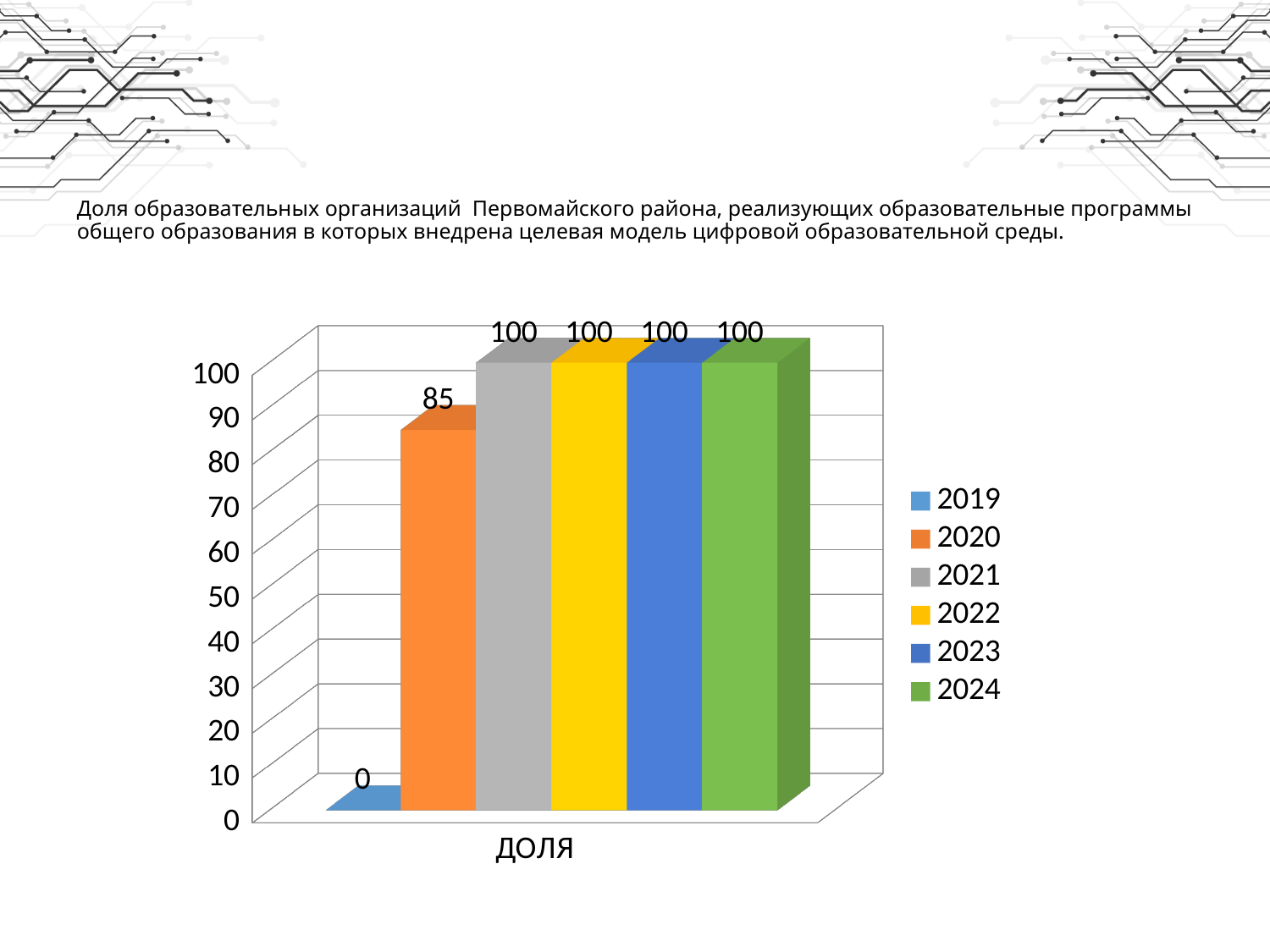
What colour is the bar for 2024? green What is the category label on the x axis? ДОЛЯ What kind of chart is shown? bar chart Which year has the lowest value? 2019 Is the value for 2020 greater or less than 80? greater What is the value for 2022? 100 What is the value for 2019? 0 Do the values rise or fall from 2019 to 2024? rise Which is larger, the value for 2020 or the value for 2023? 2023 How many series does the legend list? 6 What is the difference between the values for 2021 and 2020? 15 What is the value for 2020? 85